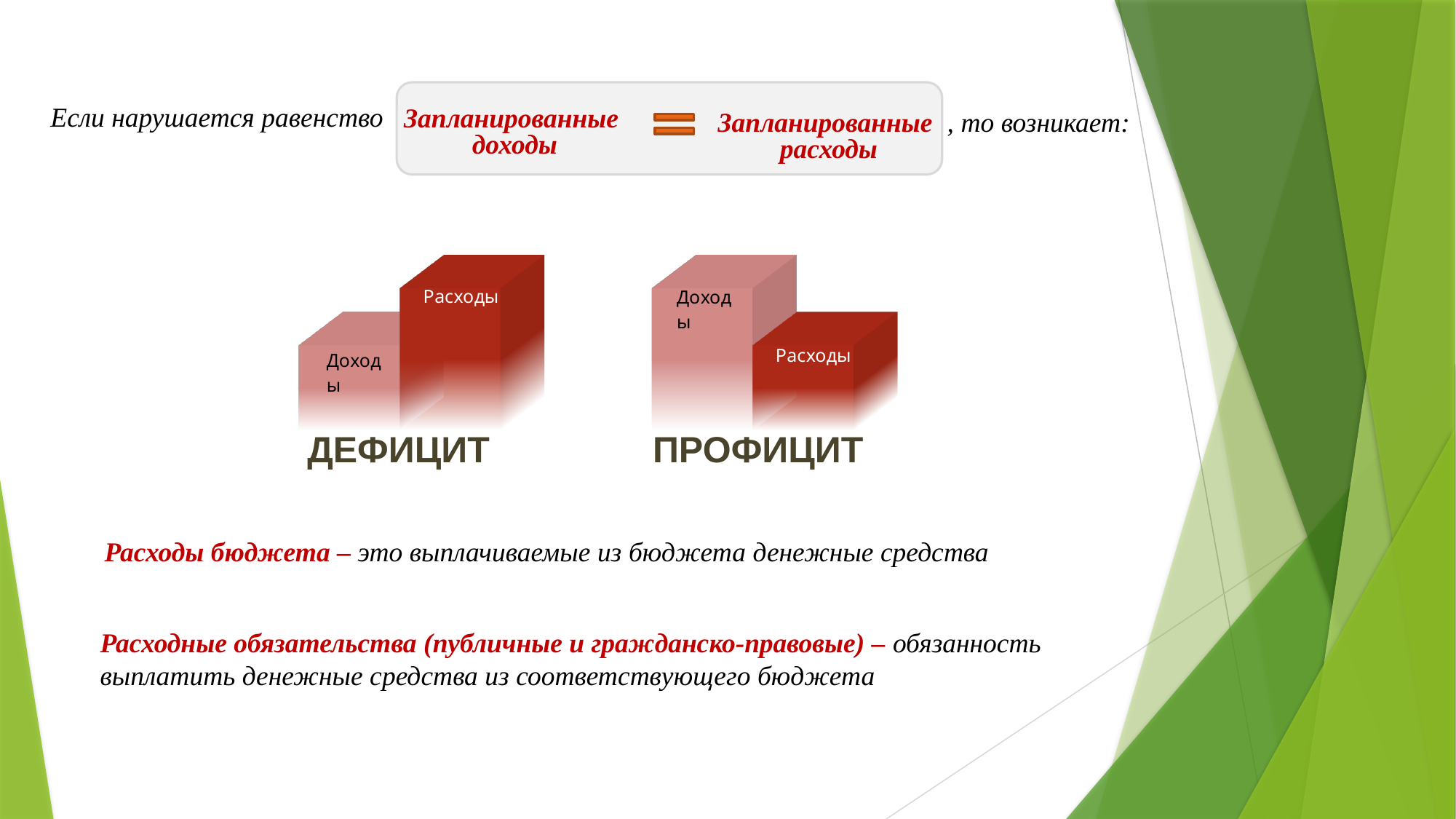
What is the label under the left chart, where Расходы exceeds Доходы? ДЕФИЦИТ How many bars are shown in the ДЕФИЦИТ chart? 2 How many bars are shown in the ПРОФИЦИТ chart? 2 In the ДЕФИЦИТ chart, which bar is taller, Доходы or Расходы? Расходы In the ДЕФИЦИТ chart, which bar is the highest? Расходы In the ПРОФИЦИТ chart, what colour is the Расходы bar? Dark red In the ПРОФИЦИТ chart, which bar is taller, Доходы or Расходы? Доходы In the ПРОФИЦИТ chart, which bar is the highest? Доходы What kind of chart is used to illustrate ДЕФИЦИТ and ПРОФИЦИТ? Bar chart In the ПРОФИЦИТ chart, which bar is the lowest? Расходы How many bar charts are shown on the slide? 1 In the ДЕФИЦИТ chart, which bar is the lowest? Доходы